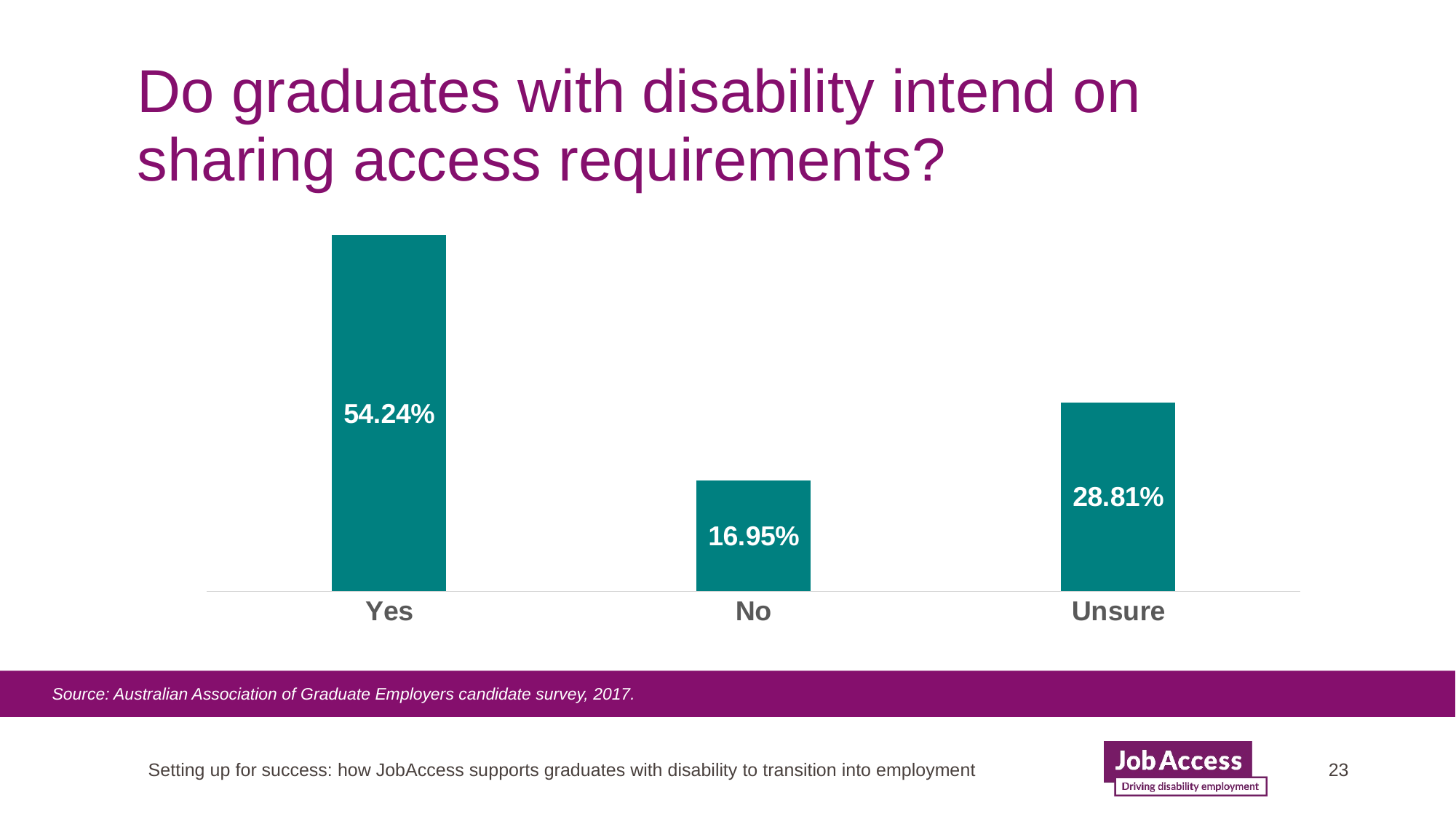
Which response has the lowest percentage? No What type of chart is shown on the slide? Bar chart Which response has the highest percentage? Yes What percentage of graduates answered No? 16.95% Which is larger, the percentage for Unsure or the percentage for No? Unsure What is the title of the slide containing the chart? Do graduates with disability intend on sharing access requirements? How many response categories are shown in the chart? 3 What is the difference in percentage points between Yes and No? 37.29 What percentage of graduates answered Unsure? 28.81% What percentage of graduates answered Yes? 54.24% What is the source of the data shown in the chart? Australian Association of Graduate Employers candidate survey, 2017 What is the difference in percentage points between Unsure and No? 11.86